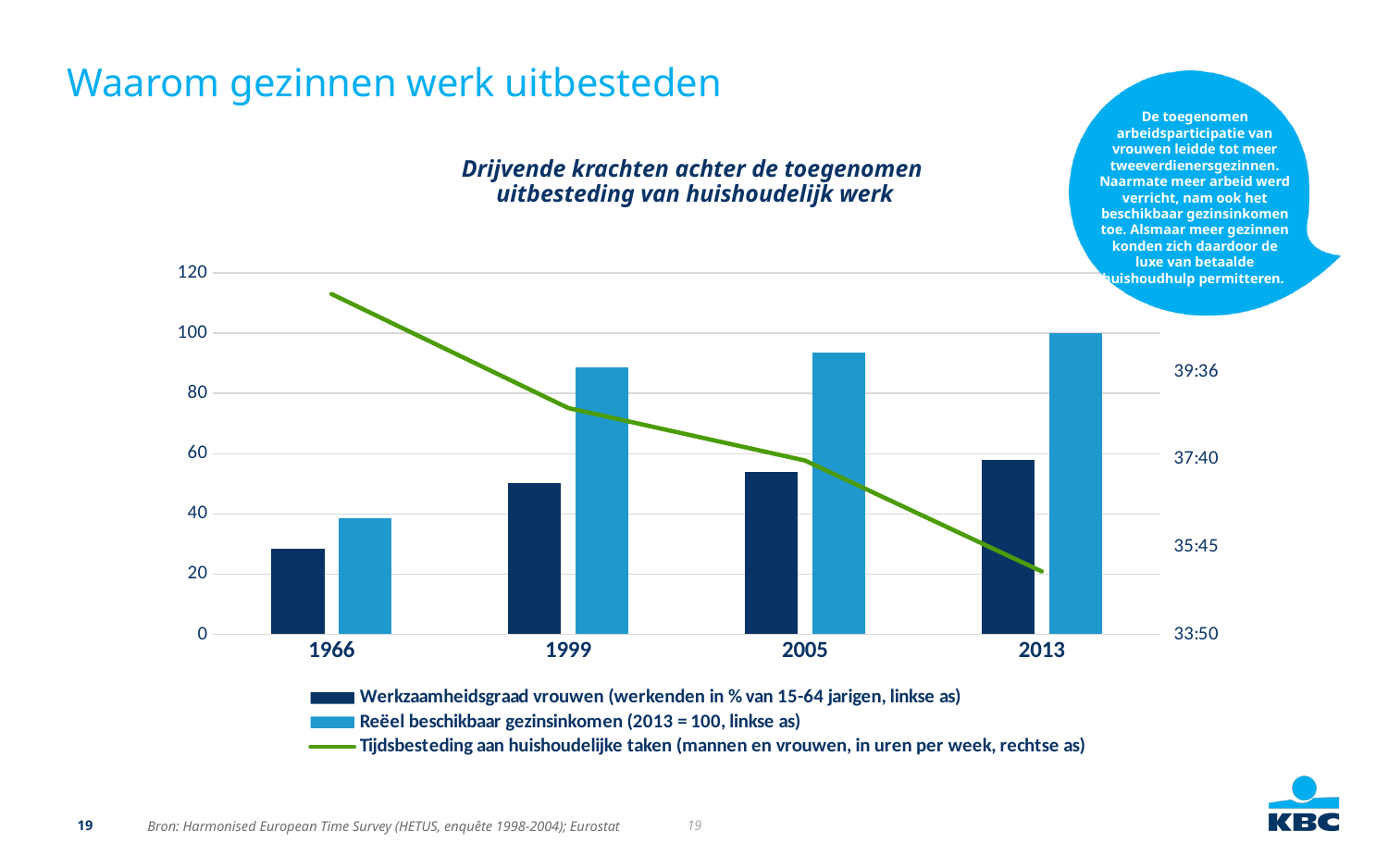
How many series does the chart legend list? 3 Is the value for Werkzaamheidsgraad vrouwen in 1966 greater or less than 40? less In which year is the Werkzaamheidsgraad vrouwen lowest? 1966 Does the line for Tijdsbesteding aan huishoudelijke taken rise or fall from 1966 to 2013? fall Is the value for Reëel beschikbaar gezinsinkomen in 1999 greater or less than 80? greater Is the value for Reëel beschikbaar gezinsinkomen in 1966 greater or less than 60? less What is the value of Reëel beschikbaar gezinsinkomen in 2013? 100 How many years are shown on the x axis of the chart? 4 What kind of chart is shown on the slide? bar chart combined with a line In 1966, which is larger: Werkzaamheidsgraad vrouwen or Reëel beschikbaar gezinsinkomen? Reëel beschikbaar gezinsinkomen Which series in the chart is plotted on the right axis? Tijdsbesteding aan huishoudelijke taken In which year is the Werkzaamheidsgraad vrouwen highest? 2013